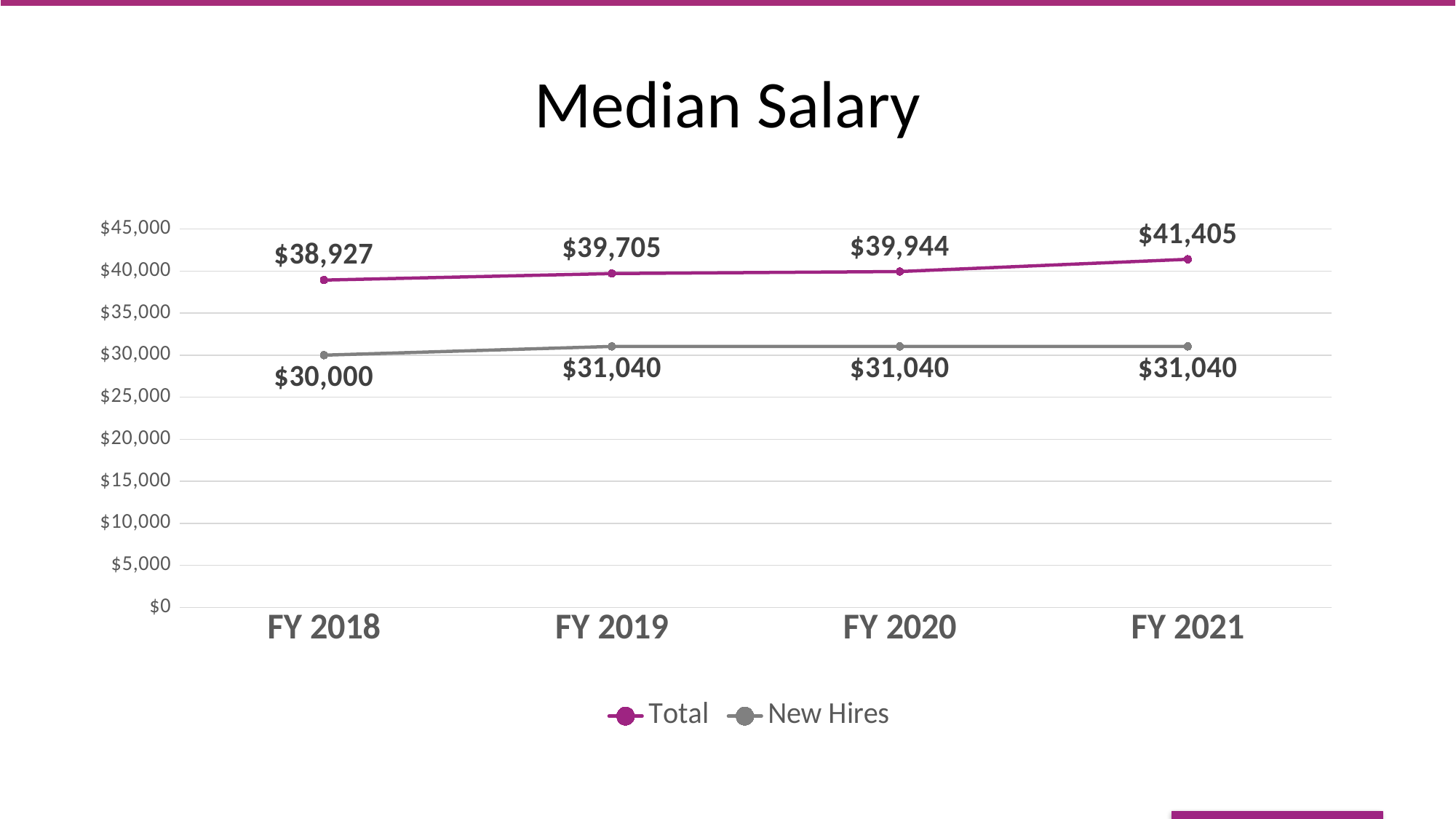
How many fiscal years are shown on the x axis? 4 What is the Total median salary for FY 2018? $38,927 Is the Total median salary for FY 2021 greater or less than $40,000? greater In which fiscal year is the New Hires median salary lowest? FY 2018 In which fiscal year is the Total median salary highest? FY 2021 By how much did the Total median salary increase from FY 2018 to FY 2021? $2,478 Which is larger in FY 2019, the Total median salary or the New Hires median salary? Total What is the difference between the Total and New Hires median salary in FY 2021? $10,365 What is the Total median salary for FY 2021? $41,405 What kind of chart is shown on the slide? Line chart How many series does the legend list? 2 What is the New Hires median salary for FY 2020? $31,040